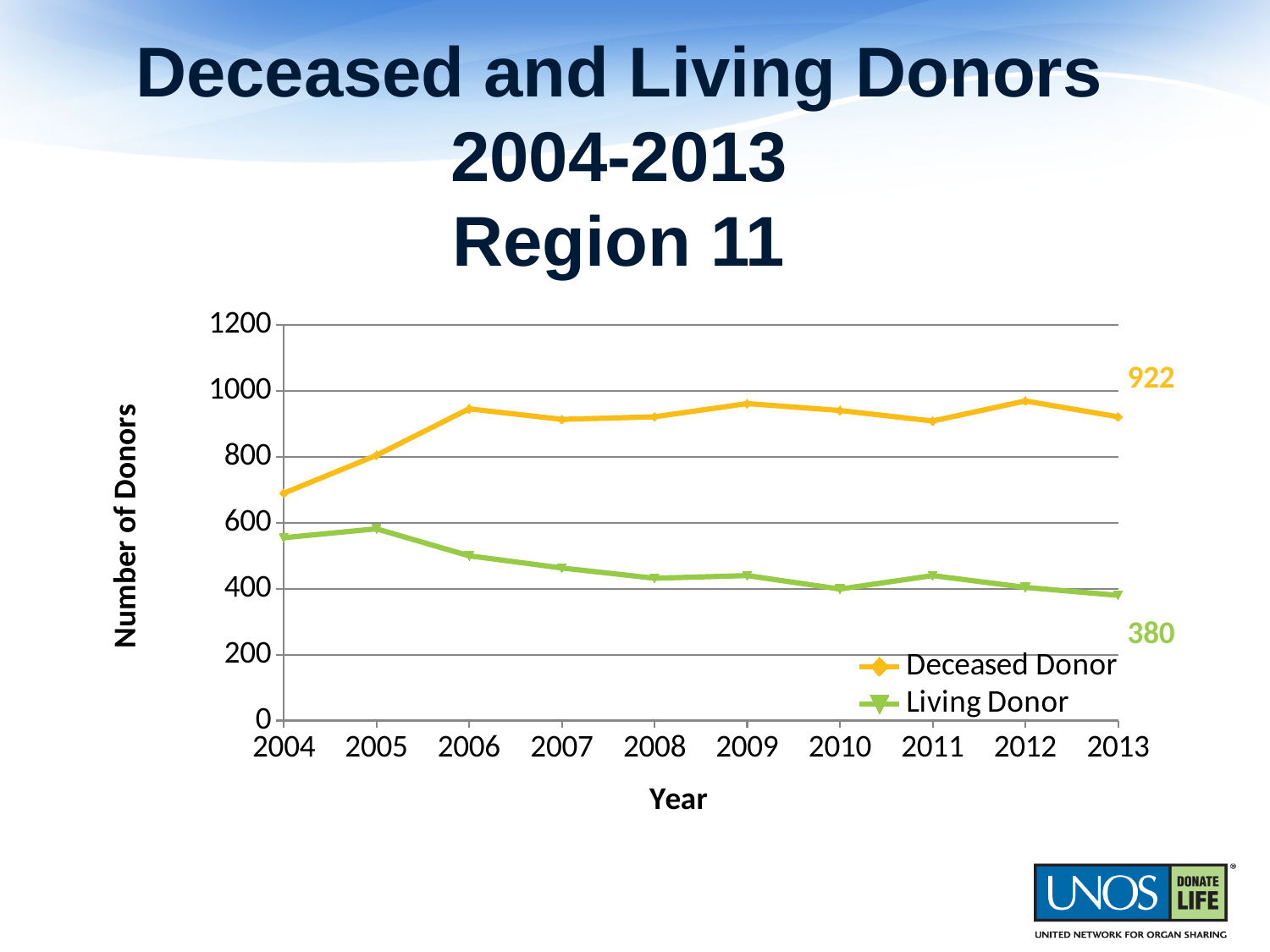
Is the value for Deceased Donor in 2004 greater or less than 800? less What is the label on the y axis? Number of Donors In 2013, which series has the larger value, Deceased Donor or Living Donor? Deceased Donor What kind of chart is shown on the slide? line chart How many series does the legend list? 2 In which year is the Deceased Donor value lowest? 2004 What is the value for Living Donor in 2013? 380 What is the value for Deceased Donor in 2013? 922 Does the Living Donor series rise or fall overall from 2004 to 2013? fall What is the difference between the Deceased Donor and Living Donor values in 2013? 542 How many years are plotted on the x axis? 10 Is the value for Living Donor in 2006 greater or less than 400? greater